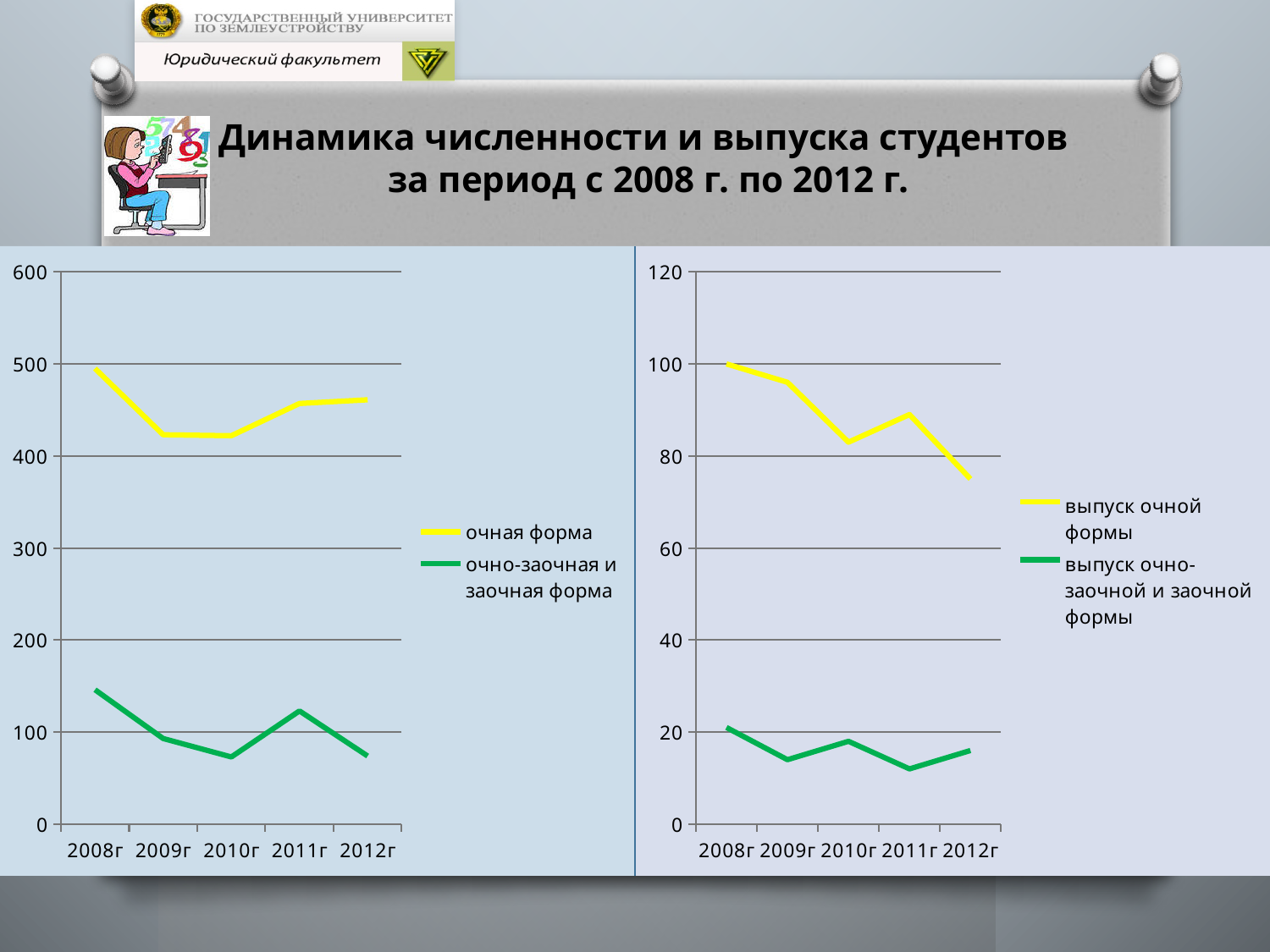
In the left chart, in which year is the value for очно-заочная и заочная форма highest? 2008г In the left chart, is the value for очно-заочная и заочная форма in 2010г greater or less than 100? less In the right chart, in which year is the value for выпуск очной формы lowest? 2012г In the right chart, is the value for выпуск очной формы in 2012г greater or less than 80? less In the left chart, which series has the larger value in 2012г, очная форма or очно-заочная и заочная форма? очная форма What colour is the line for очная форма in the left chart? yellow How many series does the legend of the right chart list? 2 How many years are shown on the x axis of the left chart? 5 In the right chart, does the value for выпуск очной формы generally rise or fall from 2008г to 2012г? fall In the left chart, is the value for очная форма in 2008г greater or less than 400? greater What kind of chart is the left chart on the slide? line chart